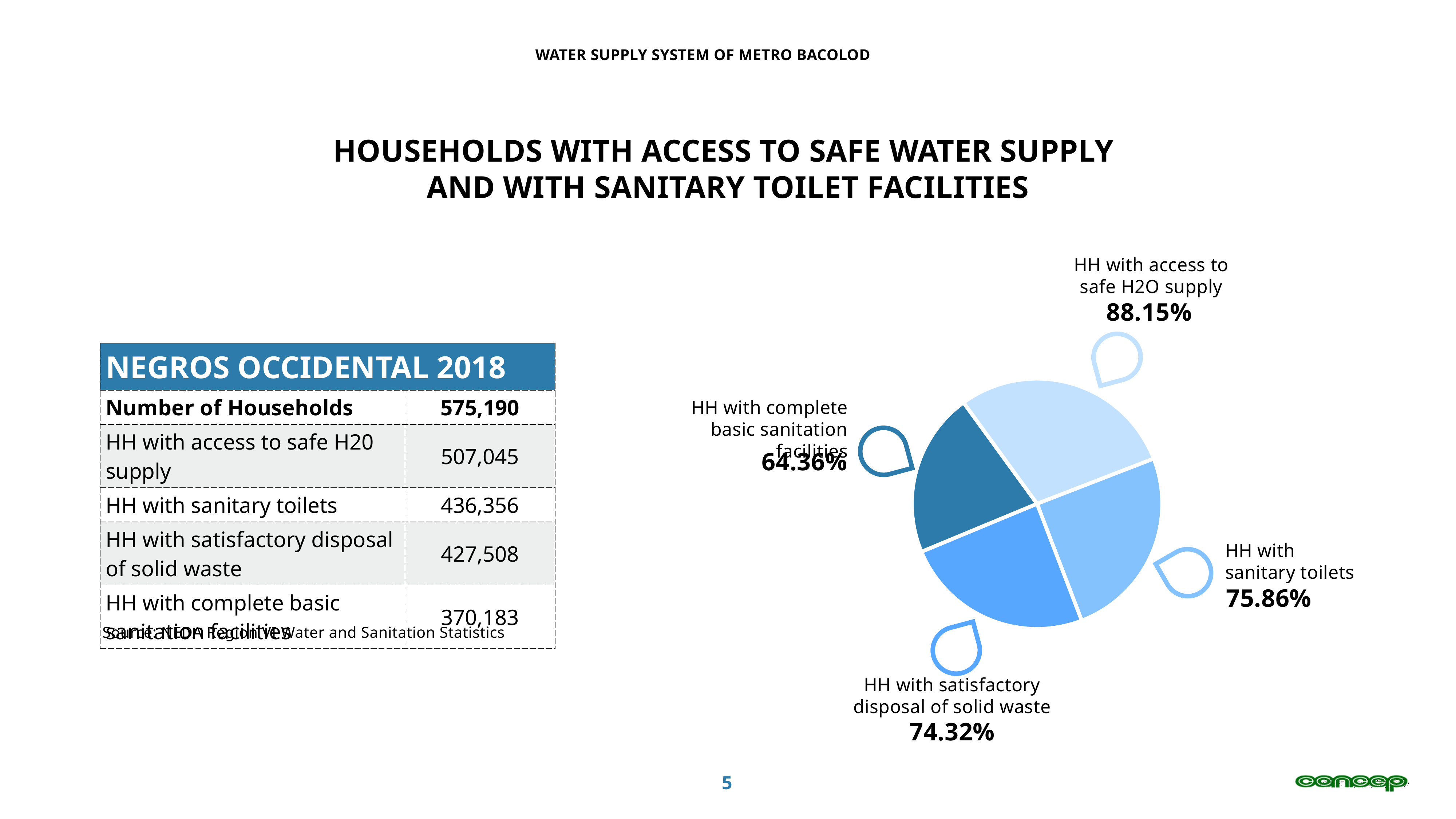
In the pie chart, which is larger: the percentage for HH with sanitary toilets or for HH with satisfactory disposal of solid waste? HH with sanitary toilets In the pie chart, what is the difference in percentage points between HH with access to safe H2O supply and HH with complete basic sanitation facilities? 23.79 In the pie chart, what percentage is shown for HH with complete basic sanitation facilities? 64.36% Which category is shown by the darkest blue slice in the pie chart? HH with complete basic sanitation facilities In the pie chart, what percentage is shown for HH with access to safe H2O supply? 88.15% What kind of chart is shown on the right of the slide? pie chart How many slices does the pie chart have? 4 In the pie chart, what percentage is shown for HH with sanitary toilets? 75.86% Which category in the pie chart has the highest percentage? HH with access to safe H2O supply In the pie chart, what percentage is shown for HH with satisfactory disposal of solid waste? 74.32% Which category in the pie chart has the lowest percentage? HH with complete basic sanitation facilities In the pie chart, what is the difference in percentage points between HH with sanitary toilets and HH with satisfactory disposal of solid waste? 1.54